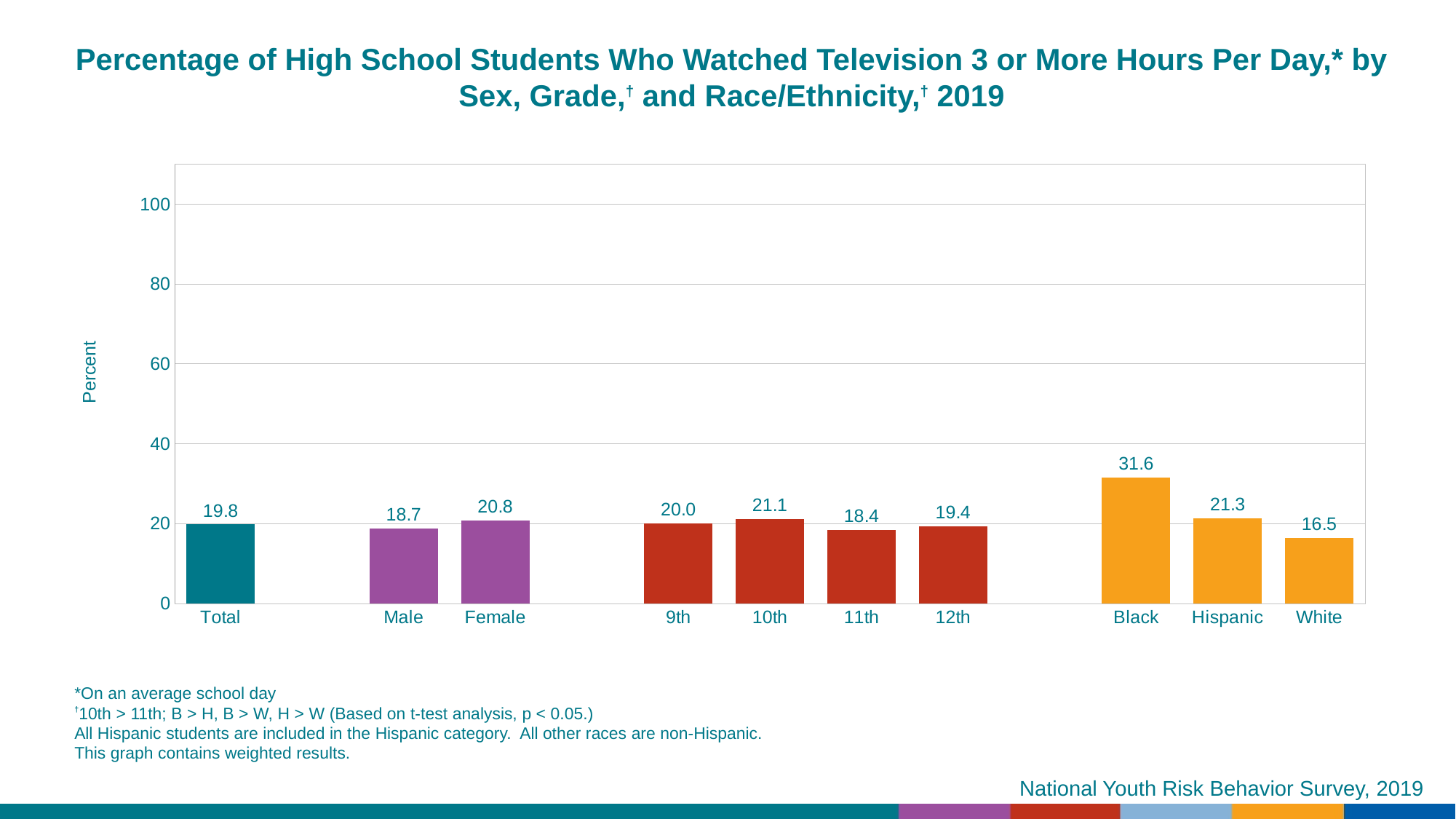
How many categories are shown on the x axis? 10 Which category has the highest value? Black What percentage of Black students watched television 3 or more hours per day? 31.6 Which is larger, the value for 10th grade or the value for 12th grade? 10th Is the value for Black greater or less than 40? less What kind of chart is shown on the slide? bar chart What is the value for Total? 19.8 What is the label of the y axis? Percent What is the difference between the Black and Hispanic values? 10.3 Which category has the lowest value? White What is the value for 11th grade students? 18.4 What is the difference between the Female and Male values? 2.1